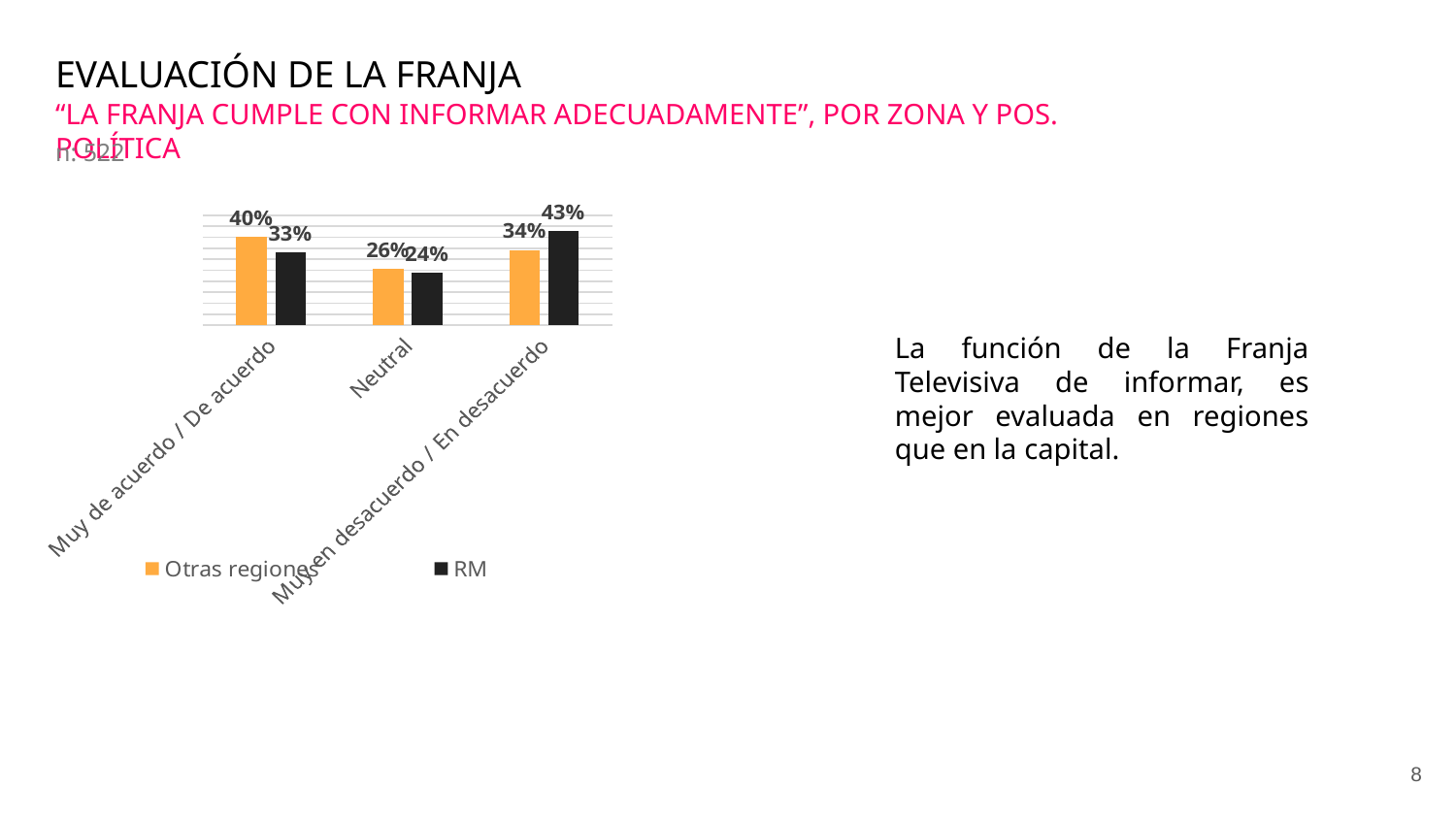
In the Muy de acuerdo / De acuerdo category, which series has the larger value, Otras regiones or RM? Otras regiones How many categories are shown on the x axis? 3 What is the difference between RM and Otras regiones in the Muy en desacuerdo / En desacuerdo category? 9% Which category has the highest value for the RM series? Muy en desacuerdo / En desacuerdo Which category has the lowest value for the Otras regiones series? Neutral What is the value for Otras regiones in the Neutral category? 26% What is the value for RM in the Muy de acuerdo / De acuerdo category? 33% What is the value for Otras regiones in the Muy de acuerdo / De acuerdo category? 40% What kind of chart is shown on the slide? Bar chart What is the value for RM in the Muy en desacuerdo / En desacuerdo category? 43% Which colour represents the RM series in the chart? Black How many series does the legend list? 2